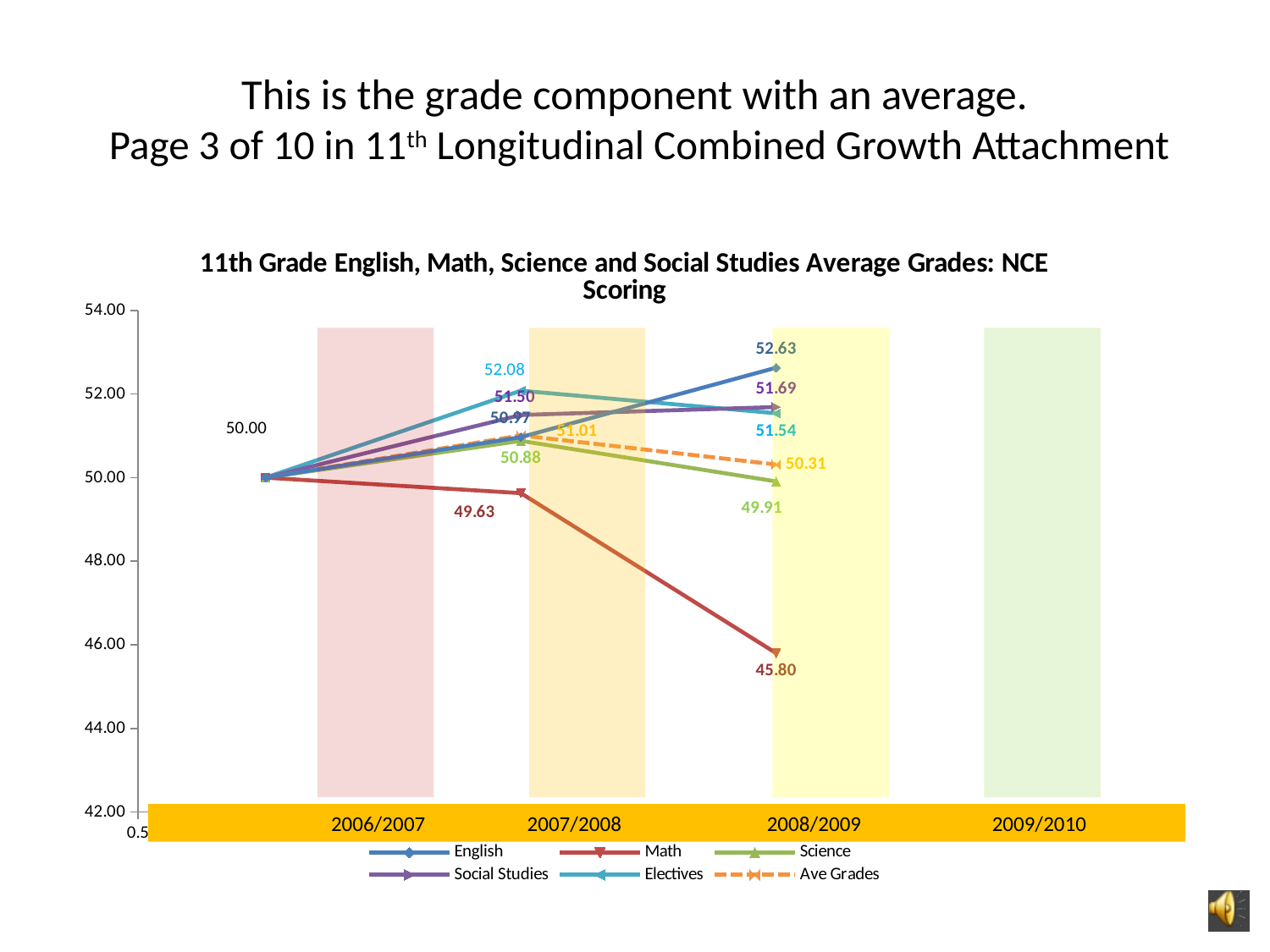
What is the Math value at 2008/2009? 45.80 Which series has the lowest value at 2008/2009? Math Which series has the highest value at 2008/2009? English What is the difference between the English and Math values at 2008/2009? 6.83 What is the Ave Grades value at 2008/2009? 50.31 What is the Electives value at 2007/2008? 52.08 What is the Science value at 2007/2008? 50.88 Does the Math series rise or fall from its starting point of 50.00 to 2008/2009? Falls What type of chart is shown on the slide? Line chart What is the title of the chart? 11th Grade English, Math, Science and Social Studies Average Grades: NCE Scoring How many series does the chart legend list? 6 What is the English value at 2008/2009? 52.63